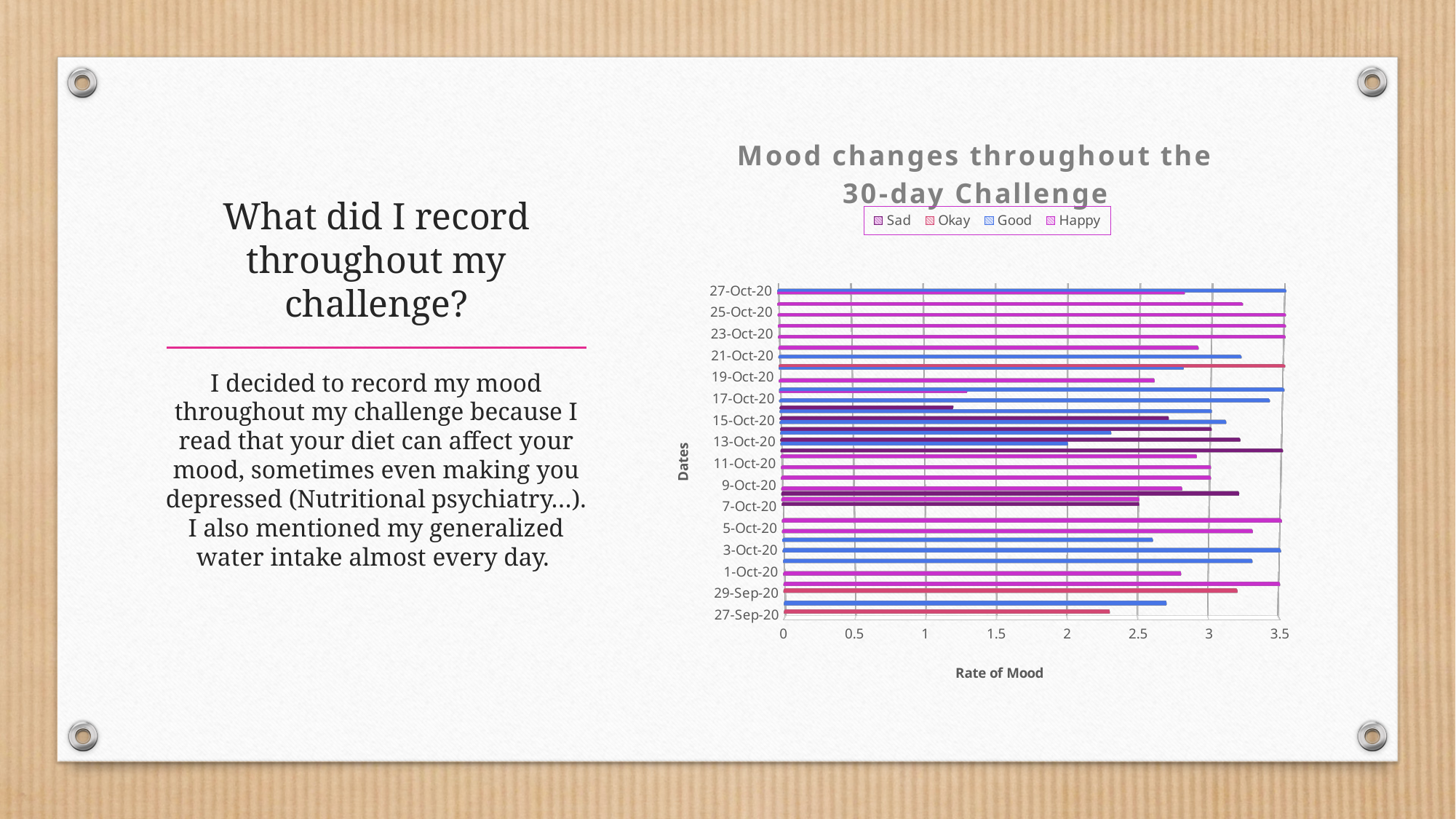
Is the value for 29-Sep-20 greater or less than 3? greater Is the value for 27-Sep-20 greater or less than 2? greater Is the value for 23-Oct-20 greater or less than 3? greater What is the label of the horizontal axis of the chart? Rate of Mood What kind of chart is shown on the slide? bar chart How many series does the legend of the chart list? 4 What is the title of the chart? Mood changes throughout the 30-day Challenge